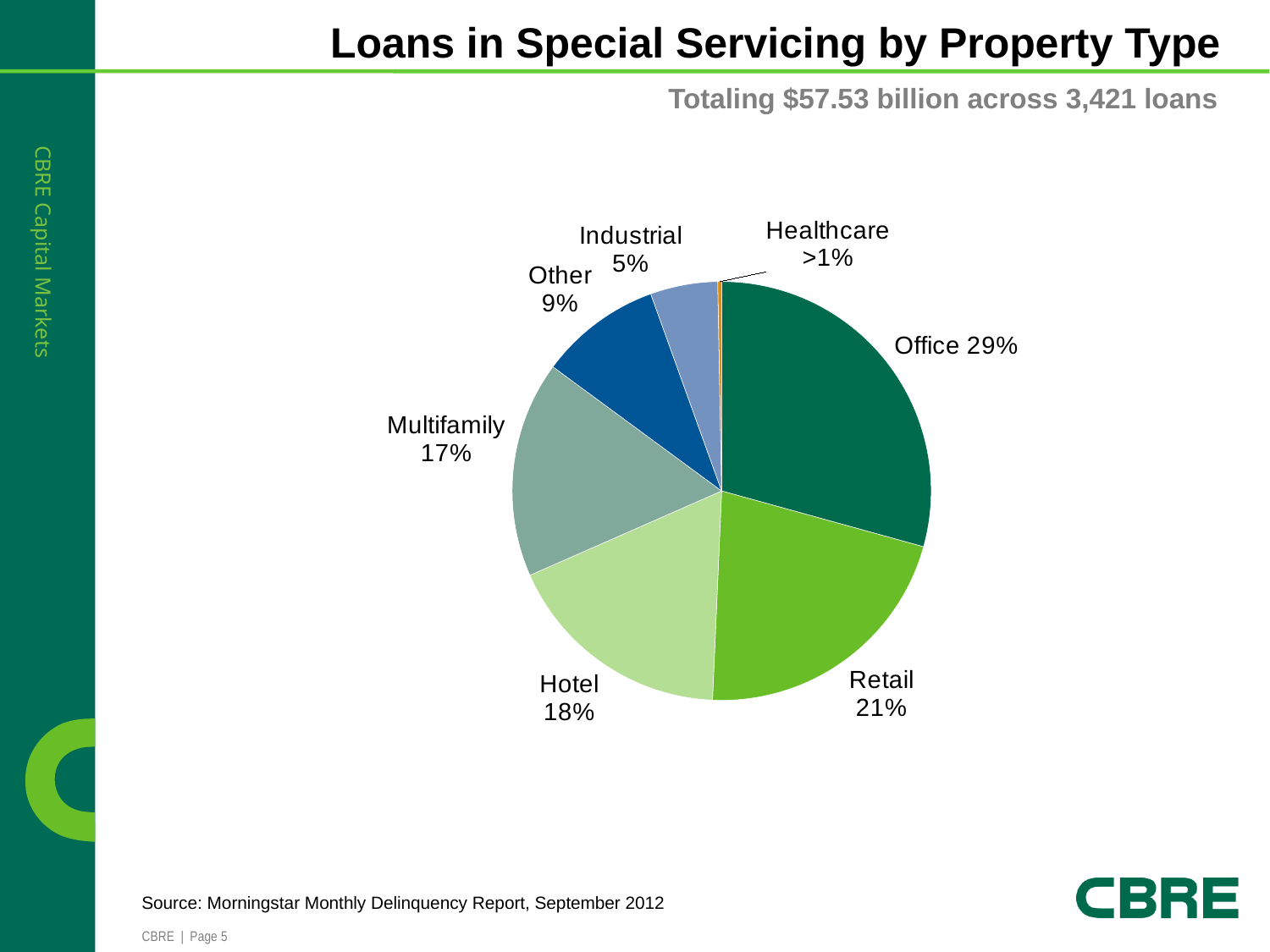
What share of loans in special servicing is Hotel? 18% What share of loans in special servicing is Industrial? 5% What share of loans in special servicing is Multifamily? 17% What is the title of the chart? Loans in Special Servicing by Property Type What share of loans in special servicing is Retail? 21% Which property type has the largest share of loans in special servicing? Office Which property type has the smallest share of loans in special servicing? Healthcare What type of chart is shown on the slide? Pie chart Which has a larger share of loans in special servicing, Other or Industrial? Other What is the difference in percentage points between the Office share and the Retail share? 8 percentage points What share of loans in special servicing is Office? 29% How many property types are shown in the pie chart? 7